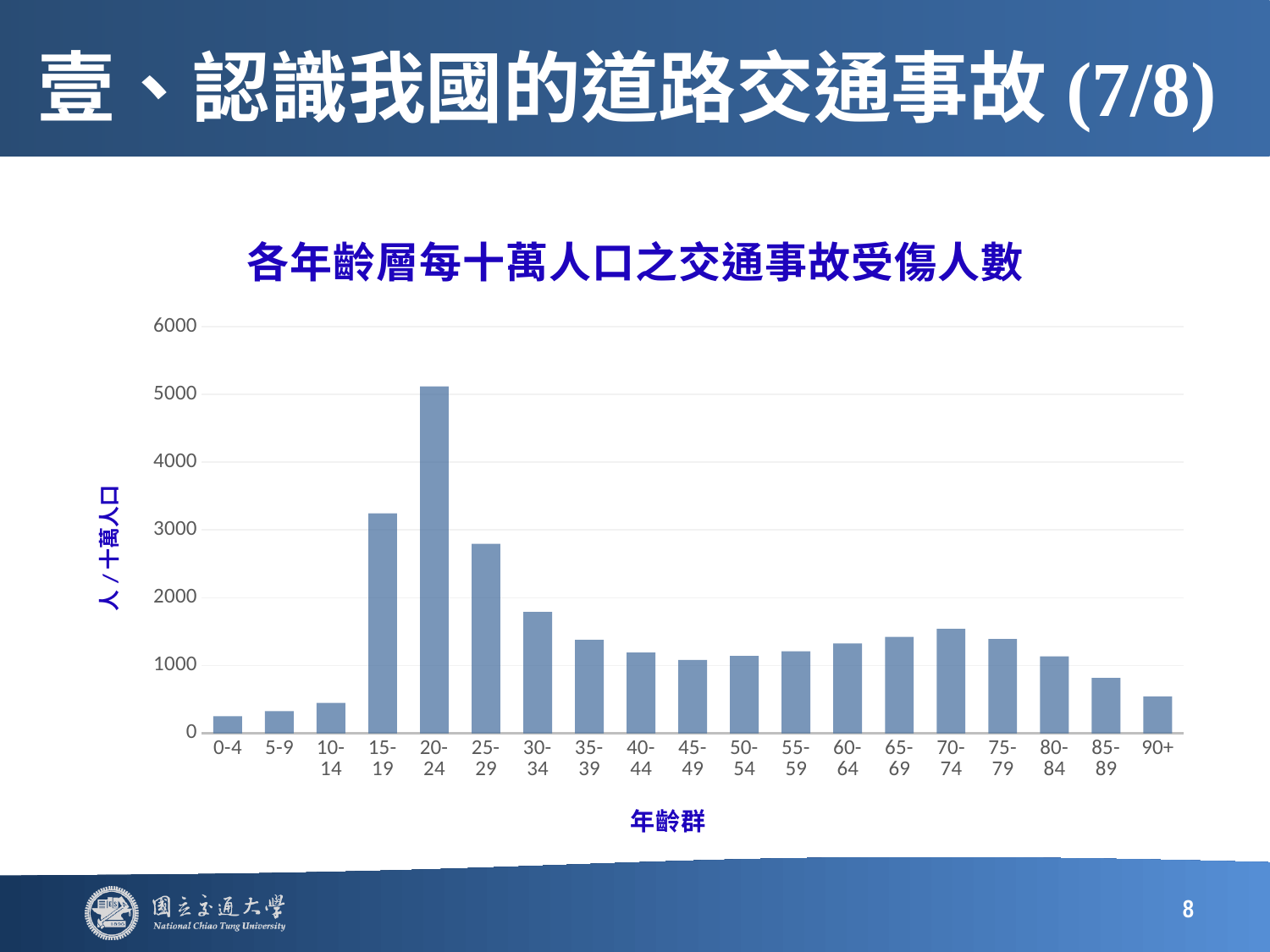
What is the title of the chart? 各年齡層每十萬人口之交通事故受傷人數 Is the value for the 20-24 age group greater or less than 4000? greater Which age group has the lowest number of injured persons per 100,000 population? 0-4 Do the values rise or fall from the 20-24 age group to the 45-49 age group? fall Is the value for the 30-34 age group greater or less than 2000? less Is the value for the 90+ age group greater or less than 1000? less Which age group has the highest number of injured persons per 100,000 population? 20-24 What is the label of the x axis? 年齡群 What kind of chart is shown on the slide? bar chart Which has a higher value, the 15-19 age group or the 25-29 age group? 15-19 How many age groups are shown on the x axis? 19